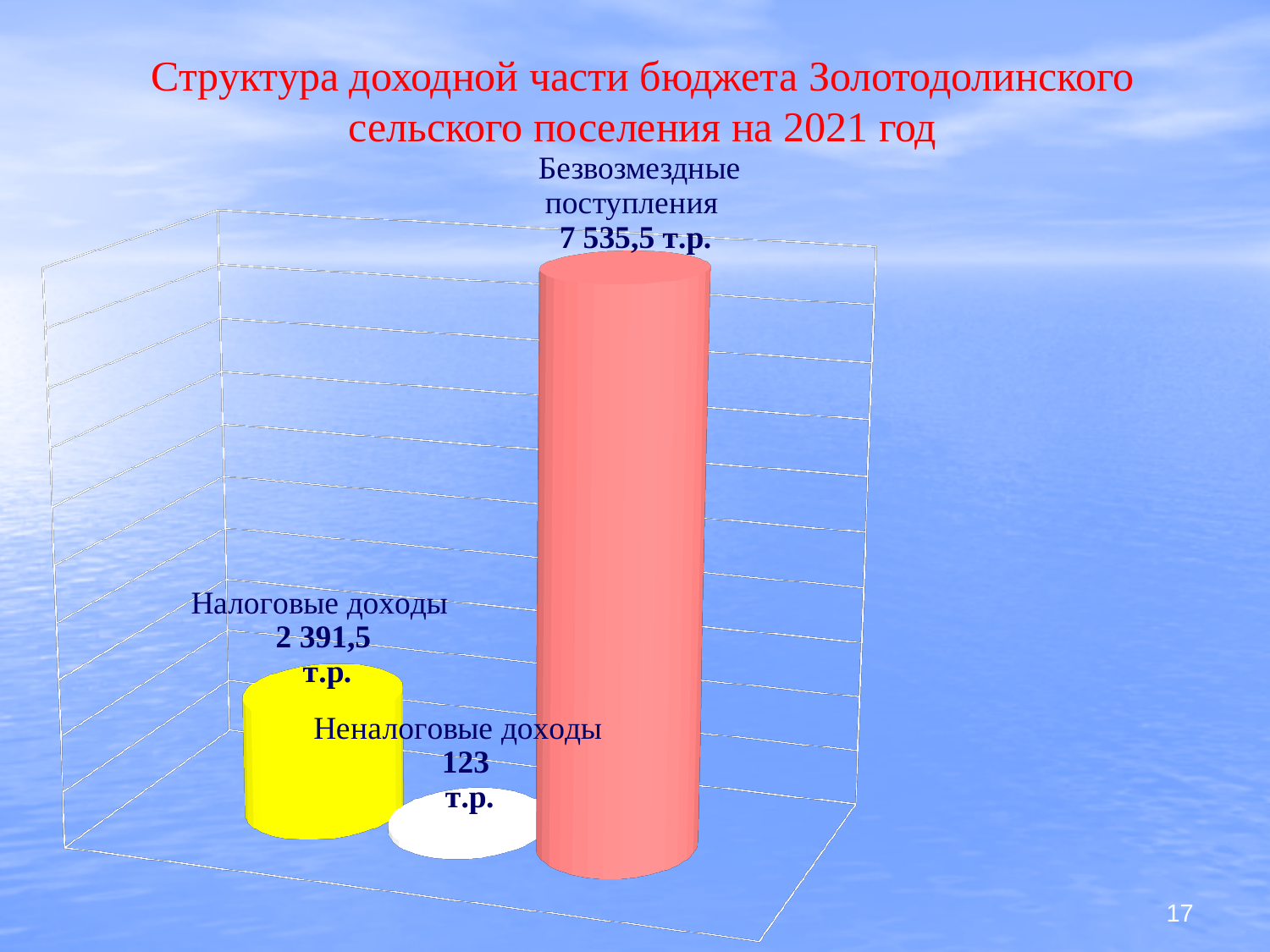
What kind of chart is shown on the slide? Bar chart What colour is the bar for Налоговые доходы? Yellow What is the value for Неналоговые доходы? 123 т.р. What is the value for Безвозмездные поступления? 7 535,5 т.р. Which category has the highest value? Безвозмездные поступления Which category has the lowest value? Неналоговые доходы Which is larger, Безвозмездные поступления or Налоговые доходы? Безвозмездные поступления How many categories are shown in the chart? 3 What is the value for Налоговые доходы? 2 391,5 т.р. What is the difference between Налоговые доходы and Неналоговые доходы? 2 268,5 т.р. Which is larger, Налоговые доходы or Неналоговые доходы? Налоговые доходы What is the difference between Безвозмездные поступления and Налоговые доходы? 5 144 т.р.